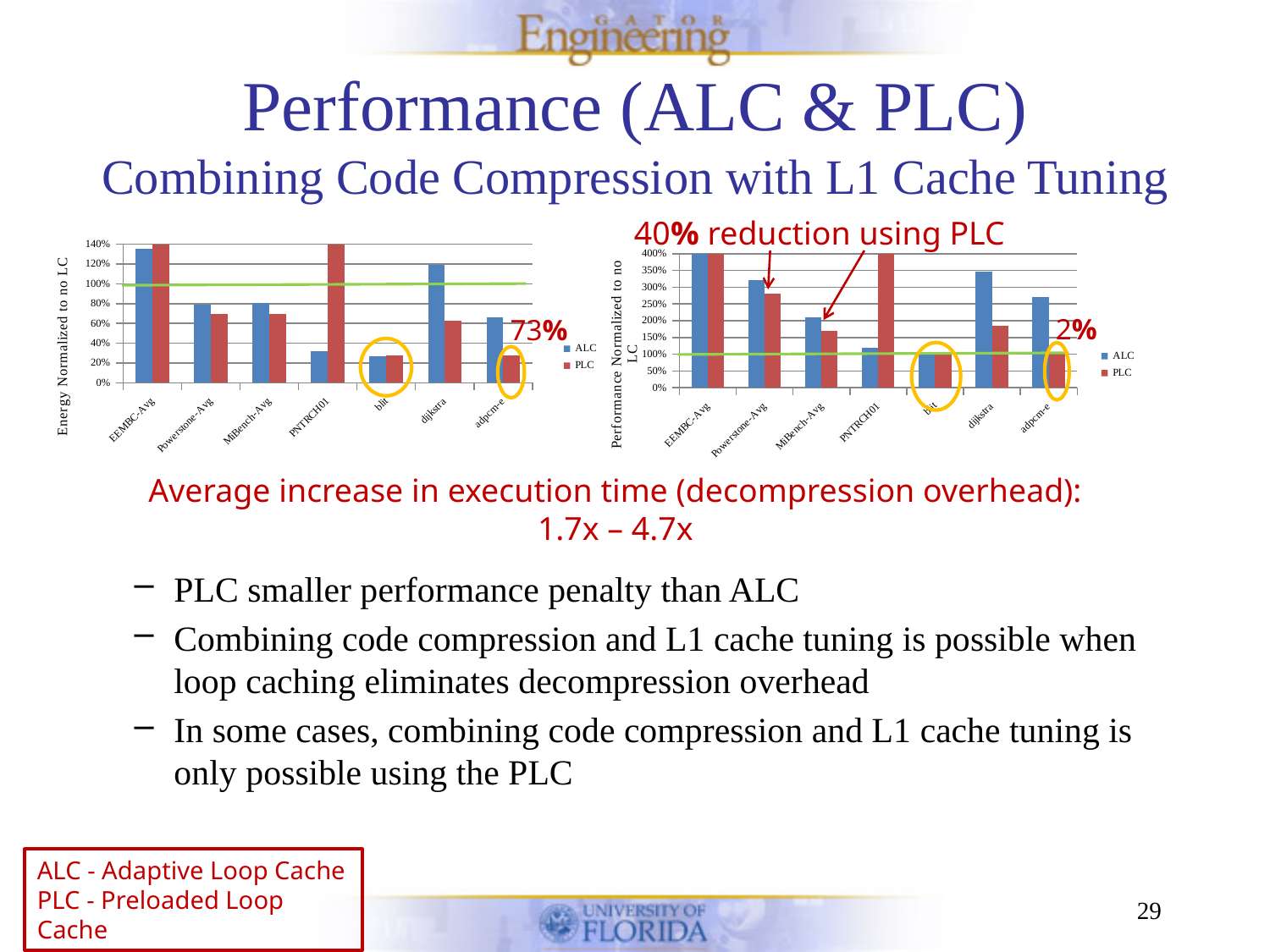
In the left chart (Energy Normalized to no LC), which is larger for PNTRCH01, ALC or PLC? PLC In the left chart (Energy Normalized to no LC), which is larger for dijkstra, ALC or PLC? ALC What is the y-axis title of the right chart? Performance Normalized to no LC What kind of chart is the left chart (Energy Normalized to no LC)? bar chart In the right chart (Performance Normalized to no LC), is the ALC value for dijkstra greater or less than 300%? greater In the left chart (Energy Normalized to no LC), which category has the highest ALC value? EEMBC-Avg In the left chart (Energy Normalized to no LC), is the ALC value for dijkstra greater or less than 100%? greater How many categories are shown on the x axis of the left chart (Energy Normalized to no LC)? 7 How many series does the legend of the right chart (Performance Normalized to no LC) list? 2 In the left chart (Energy Normalized to no LC), is the PLC value for adpcm-e greater or less than 40%? less In the right chart (Performance Normalized to no LC), which is larger for Powerstone-Avg, ALC or PLC? ALC